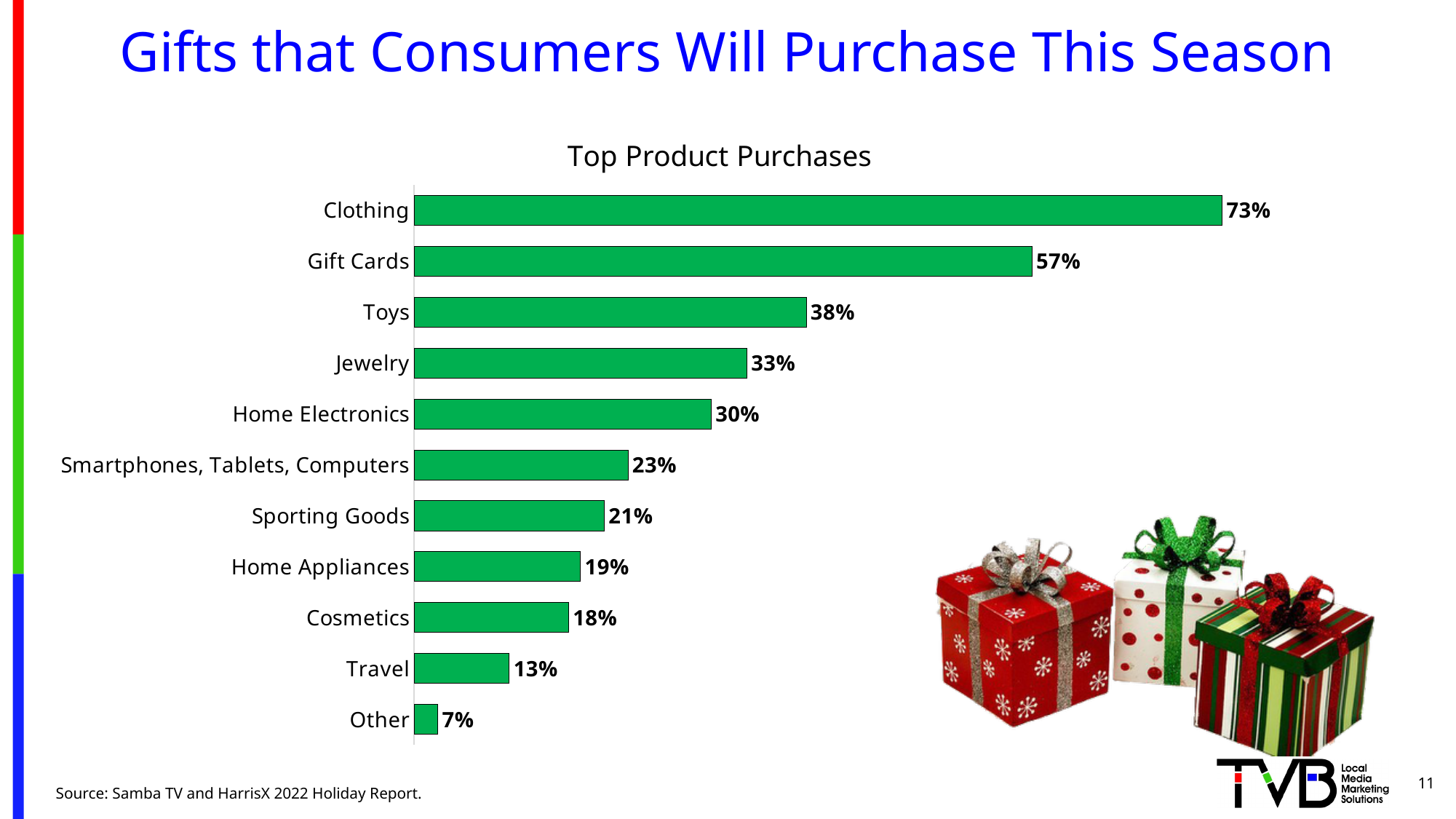
What is the value for Home Electronics? 30% What is the value for Smartphones, Tablets, Computers? 23% Which is larger, Jewelry or Sporting Goods? Jewelry What percentage of consumers will purchase Clothing? 73% What kind of chart is shown on the slide? Bar chart Which category has the lowest value? Other Which is larger, Cosmetics or Home Appliances? Home Appliances What is the difference between Clothing and Gift Cards? 16% What is the title of the chart? Top Product Purchases Which category has the highest value? Clothing What is the difference between Toys and Travel? 25% How many categories are shown in the chart? 11